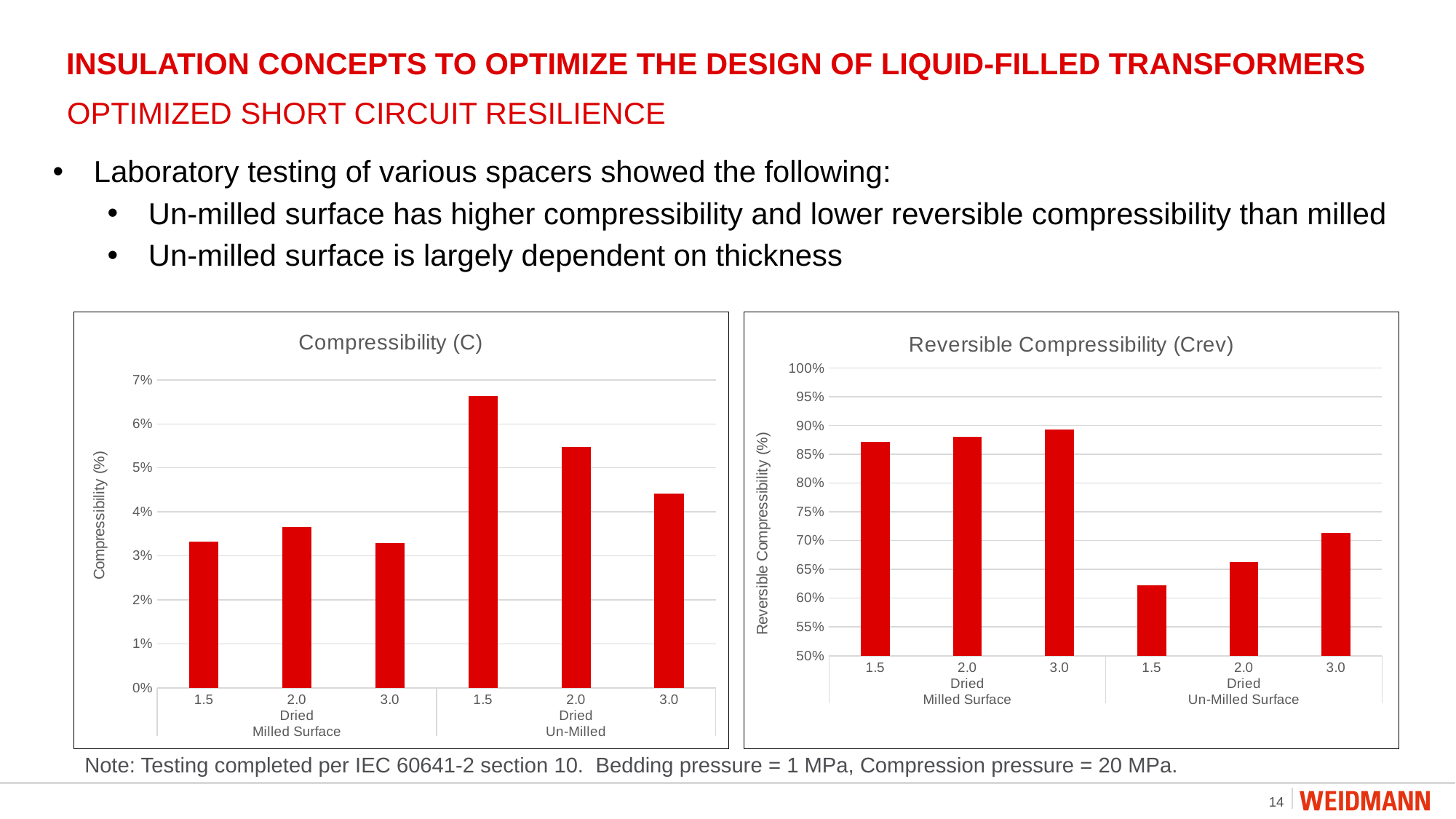
In the Reversible Compressibility (Crev) chart, do the Dried Un-Milled Surface values rise or fall as thickness increases from 1.5 to 3.0? rise In the Reversible Compressibility (Crev) chart, is the value for Dried Un-Milled Surface 1.5 greater or less than 65%? less What type of chart is the Reversible Compressibility (Crev) chart? bar chart In the Compressibility (C) chart, which is larger: Dried Un-Milled 2.0 or Dried Milled Surface 2.0? Dried Un-Milled 2.0 In the Compressibility (C) chart, is the value for Dried Un-Milled 1.5 greater or less than 6%? greater In the Compressibility (C) chart, is the value for Dried Milled Surface 2.0 greater or less than 4%? less In the Reversible Compressibility (Crev) chart, which bar is the lowest? Dried Un-Milled Surface, 1.5 In the Compressibility (C) chart, which bar is the highest? Dried Un-Milled, 1.5 In the Compressibility (C) chart, do the Dried Un-Milled values rise or fall as thickness increases from 1.5 to 3.0? fall How many bars are plotted in the Compressibility (C) chart? 6